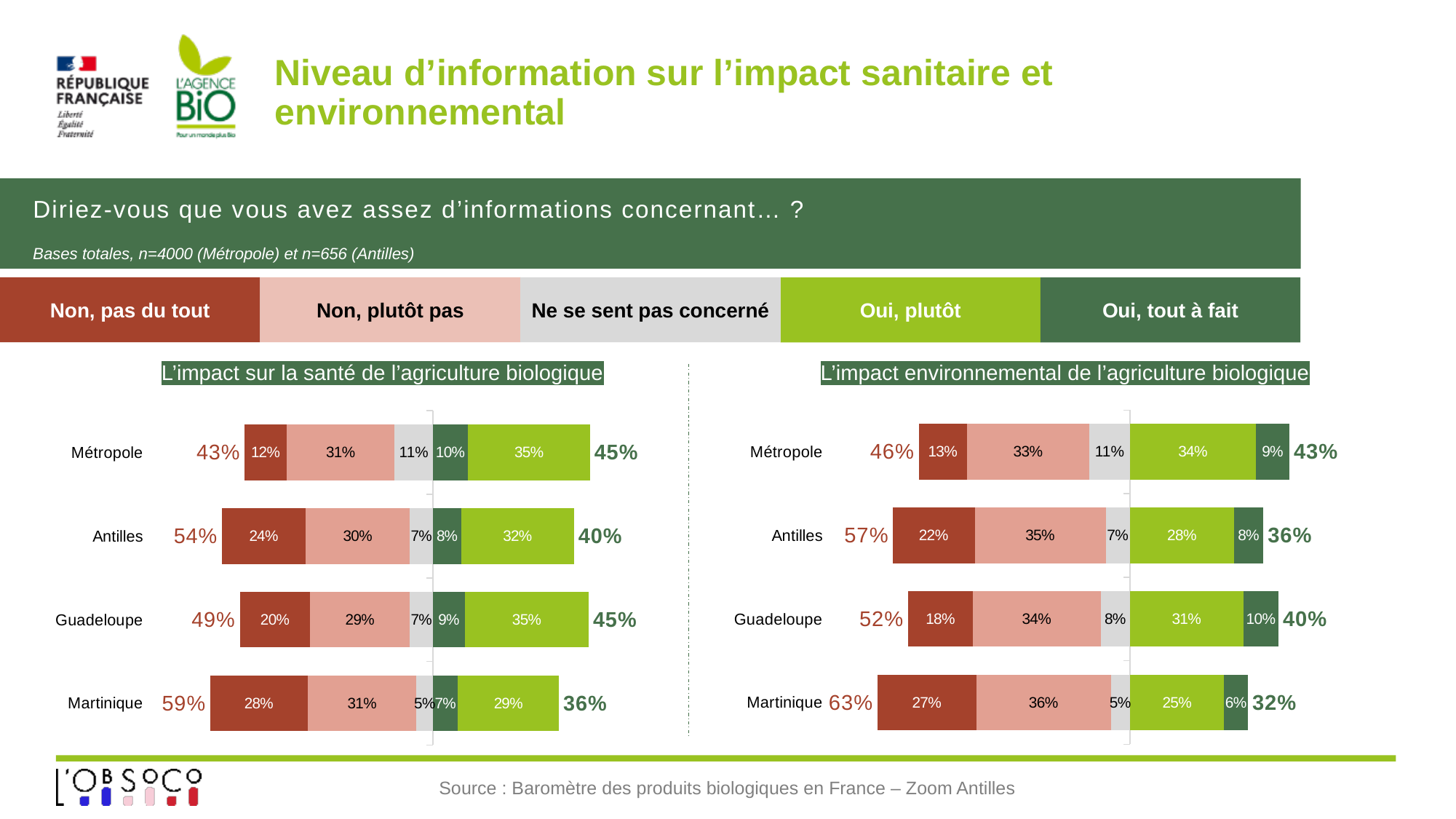
How many series does the legend list for the charts on this slide? 5 In the chart 'L'impact environnemental de l'agriculture biologique', which category has the highest 'Non, pas du tout' value? Martinique In the chart 'L'impact sur la santé de l'agriculture biologique', what is the difference between the 'Non, pas du tout' values for Antilles and Métropole? 12% In the chart 'L'impact environnemental de l'agriculture biologique', what is the combined 'Oui' total shown for Guadeloupe? 40% In the chart 'L'impact environnemental de l'agriculture biologique', what is the 'Oui, plutôt' value for Antilles? 28% In the chart 'L'impact sur la santé de l'agriculture biologique', which category has the lowest 'Oui, tout à fait' value? Martinique What kind of chart is 'L'impact environnemental de l'agriculture biologique'? Stacked bar chart In the chart 'L'impact sur la santé de l'agriculture biologique', what is the 'Non, pas du tout' value for Martinique? 28% How many categories are shown in the chart 'L'impact sur la santé de l'agriculture biologique'? 4 Which legend entry is shown in the light grey colour? Ne se sent pas concerné In the chart 'L'impact sur la santé de l'agriculture biologique', what is the 'Ne se sent pas concerné' value for Métropole? 11% In the chart 'L'impact environnemental de l'agriculture biologique', is the 'Oui, plutôt' value larger for Métropole or for Martinique? Métropole